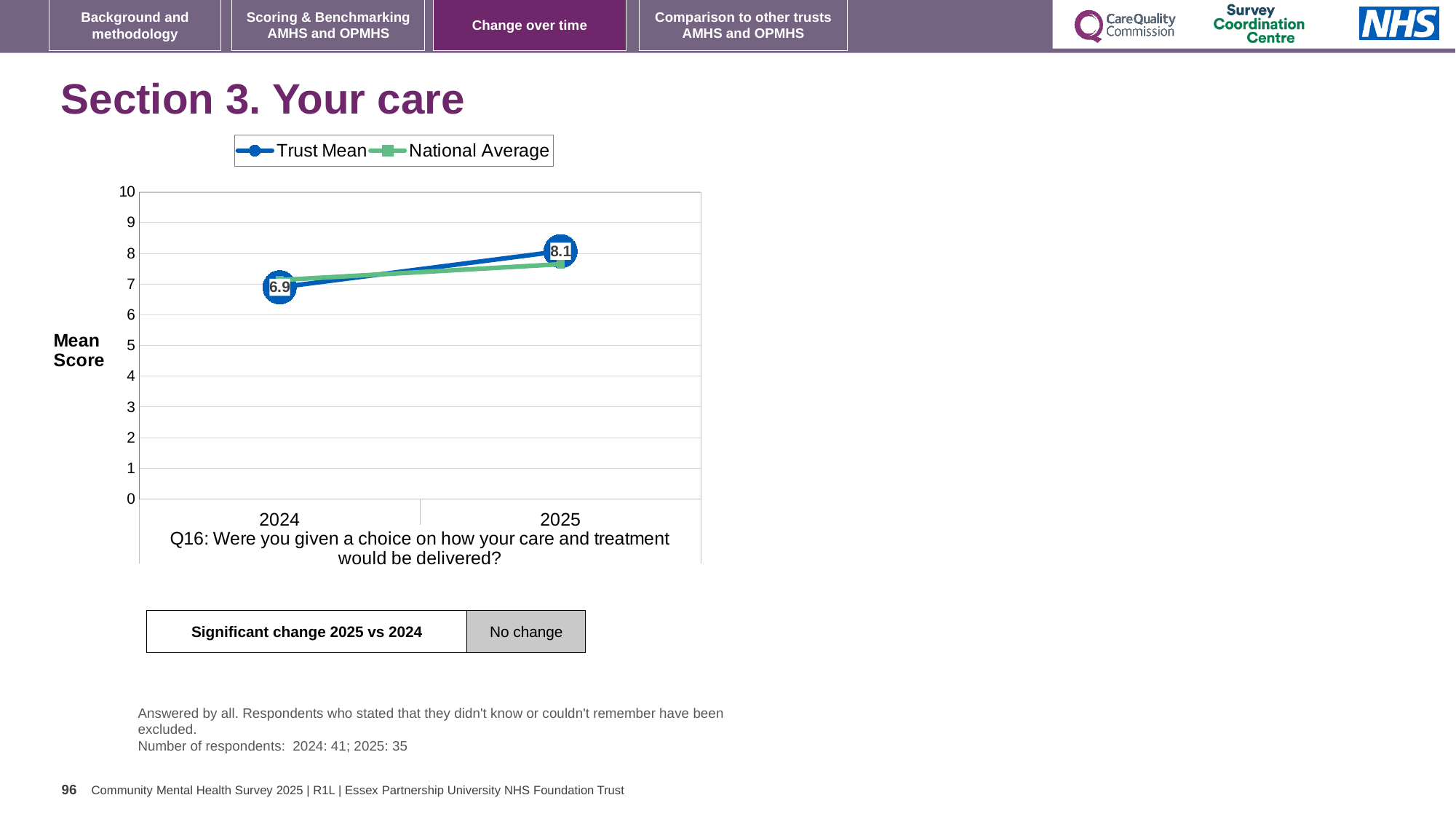
Is the National Average for 2025 greater or less than 8? less Is the National Average for 2025 greater or less than 7? greater How many series does the legend list? 2 By how much did the Trust Mean score change from 2024 to 2025? 1.2 What kind of chart is shown on the slide? line chart What is the Trust Mean score for 2025? 8.1 Which year has the lower Trust Mean score? 2024 Does the Trust Mean score rise or fall from 2024 to 2025? rise What is the Trust Mean score for 2024? 6.9 What is the label on the y axis of the chart? Mean Score In 2025, which is higher: the Trust Mean or the National Average? Trust Mean Which year has the higher Trust Mean score? 2025